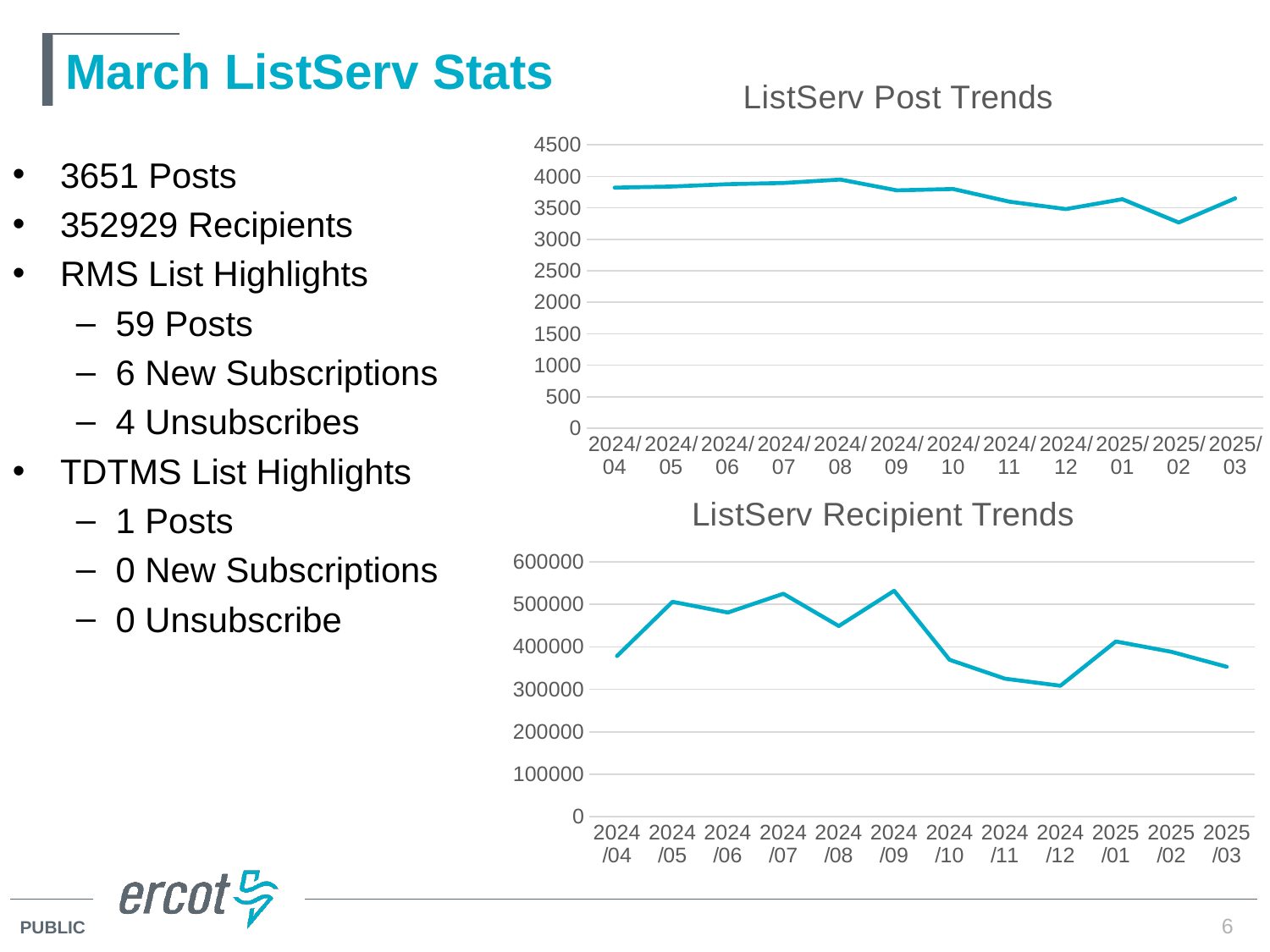
On the "ListServ Recipient Trends" chart, which month has the lowest value? 2024/12 On the "ListServ Post Trends" chart, is the value for 2024/08 greater or less than 3500? greater On the "ListServ Recipient Trends" chart, is the value for 2024/09 greater or less than 500000? greater How many data points are plotted on the "ListServ Recipient Trends" chart? 12 How many data points are plotted on the "ListServ Post Trends" chart? 12 What kind of chart is the "ListServ Post Trends" chart? line chart On the "ListServ Post Trends" chart, which month has the lowest value? 2025/02 On the "ListServ Recipient Trends" chart, is the value for 2024/10 greater or less than 400000? less On the "ListServ Post Trends" chart, which is larger, the value for 2024/08 or the value for 2025/02? 2024/08 What kind of chart is the "ListServ Recipient Trends" chart? line chart On the "ListServ Post Trends" chart, which month has the highest value? 2024/08